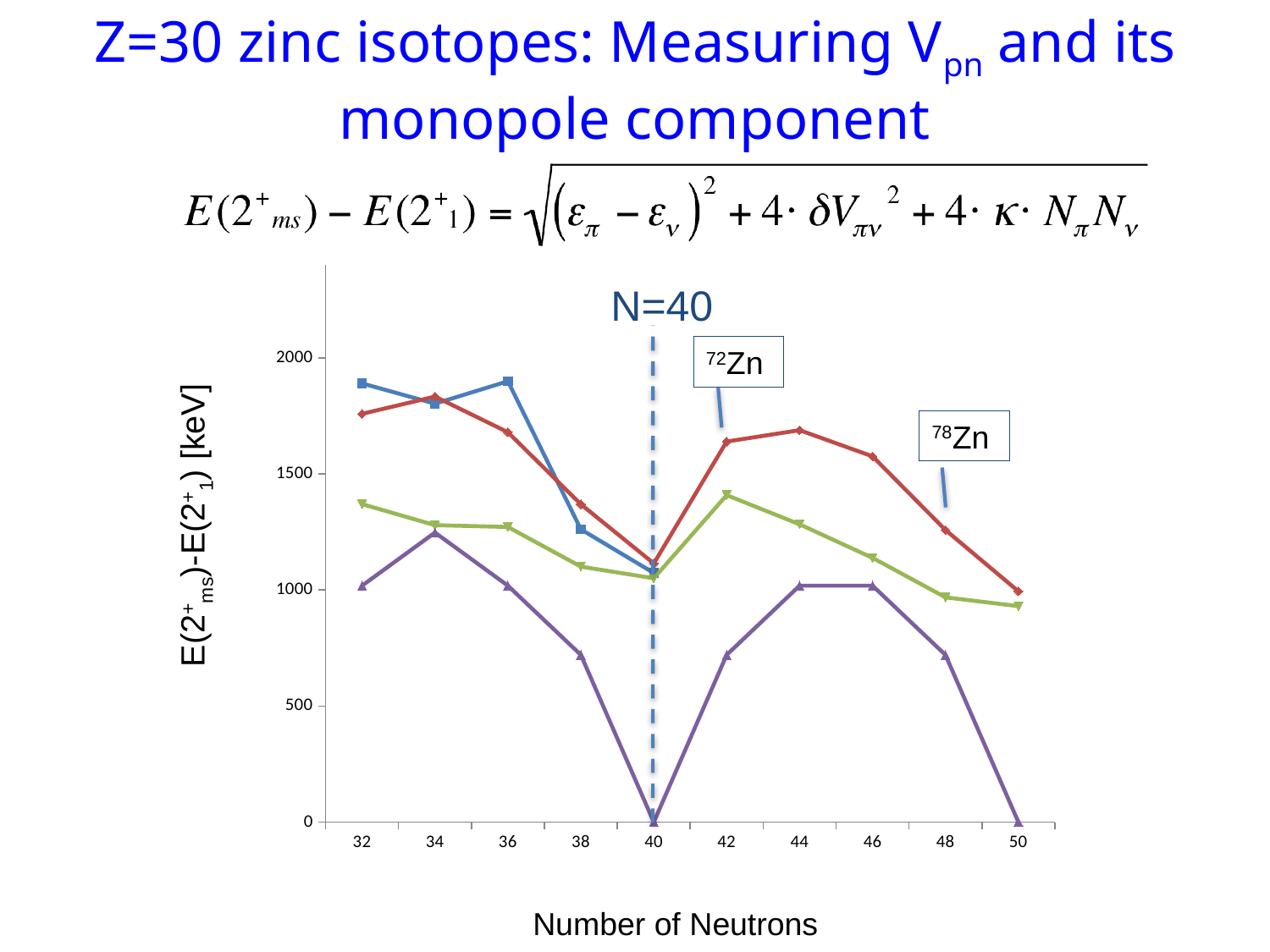
What is the label on the x axis of the chart? Number of Neutrons Is the value of the red line at 44 neutrons greater or less than 1500? greater How many neutron-number values are marked along the x axis? 10 Is the value of the green line at 42 neutrons greater or less than 1000? greater At 46 neutrons, which line has the larger value, the red line or the green line? red line Does the red line rise or fall from 44 neutrons to 50 neutrons? fall What is the value of the purple line at 50 neutrons? 0 What is the value of the purple line at 40 neutrons? 0 Is the value of the red line at 48 neutrons greater or less than 1500? less How many lines (data series) are plotted on the chart? 4 What kind of chart is shown on the slide? line chart